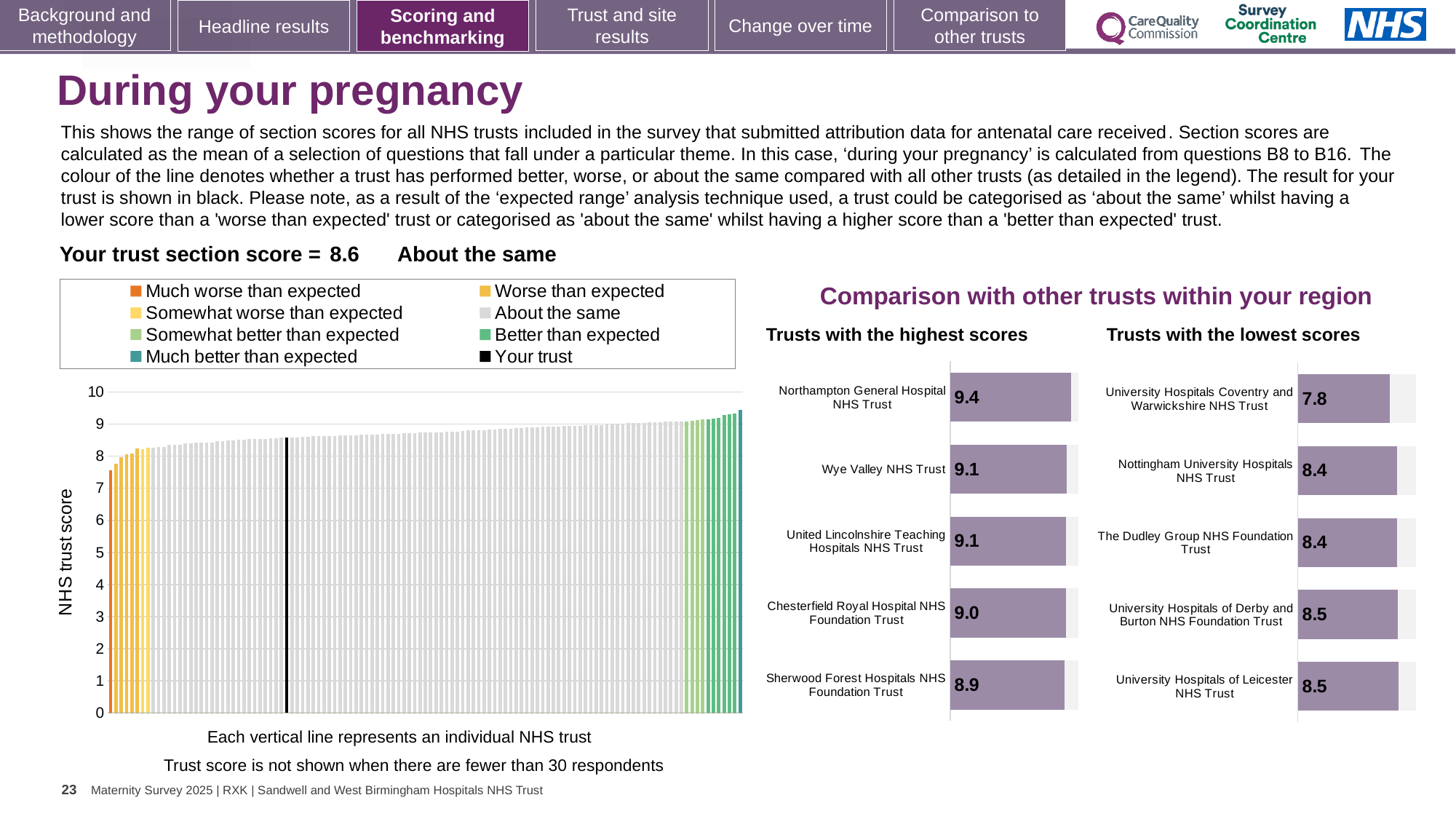
In the 'Trusts with the highest scores' chart, what is the score for Northampton General Hospital NHS Trust? 9.4 In the 'Trusts with the highest scores' chart, what is the score for Sherwood Forest Hospitals NHS Foundation Trust? 8.9 In the 'Trusts with the lowest scores' chart, what is the score for University Hospitals of Derby and Burton NHS Foundation Trust? 8.5 In the 'Trusts with the highest scores' chart, which has the higher score: Wye Valley NHS Trust or Sherwood Forest Hospitals NHS Foundation Trust? Wye Valley NHS Trust In the 'Trusts with the lowest scores' chart, what is the difference between the scores of University Hospitals of Leicester NHS Trust and University Hospitals Coventry and Warwickshire NHS Trust? 0.7 In the 'Trusts with the lowest scores' chart, what is the score for University Hospitals Coventry and Warwickshire NHS Trust? 7.8 How many trusts are shown in the 'Trusts with the lowest scores' chart? 5 How many entries does the legend of the main chart on the left list? 8 In the main chart on the left, what is the section score for your trust (the black bar)? 8.6 In the 'Trusts with the highest scores' chart, which trust has the highest score? Northampton General Hospital NHS Trust In the 'Trusts with the highest scores' chart, what is the difference between the scores of Northampton General Hospital NHS Trust and Chesterfield Royal Hospital NHS Foundation Trust? 0.4 In the 'Trusts with the lowest scores' chart, which trust has the lowest score? University Hospitals Coventry and Warwickshire NHS Trust